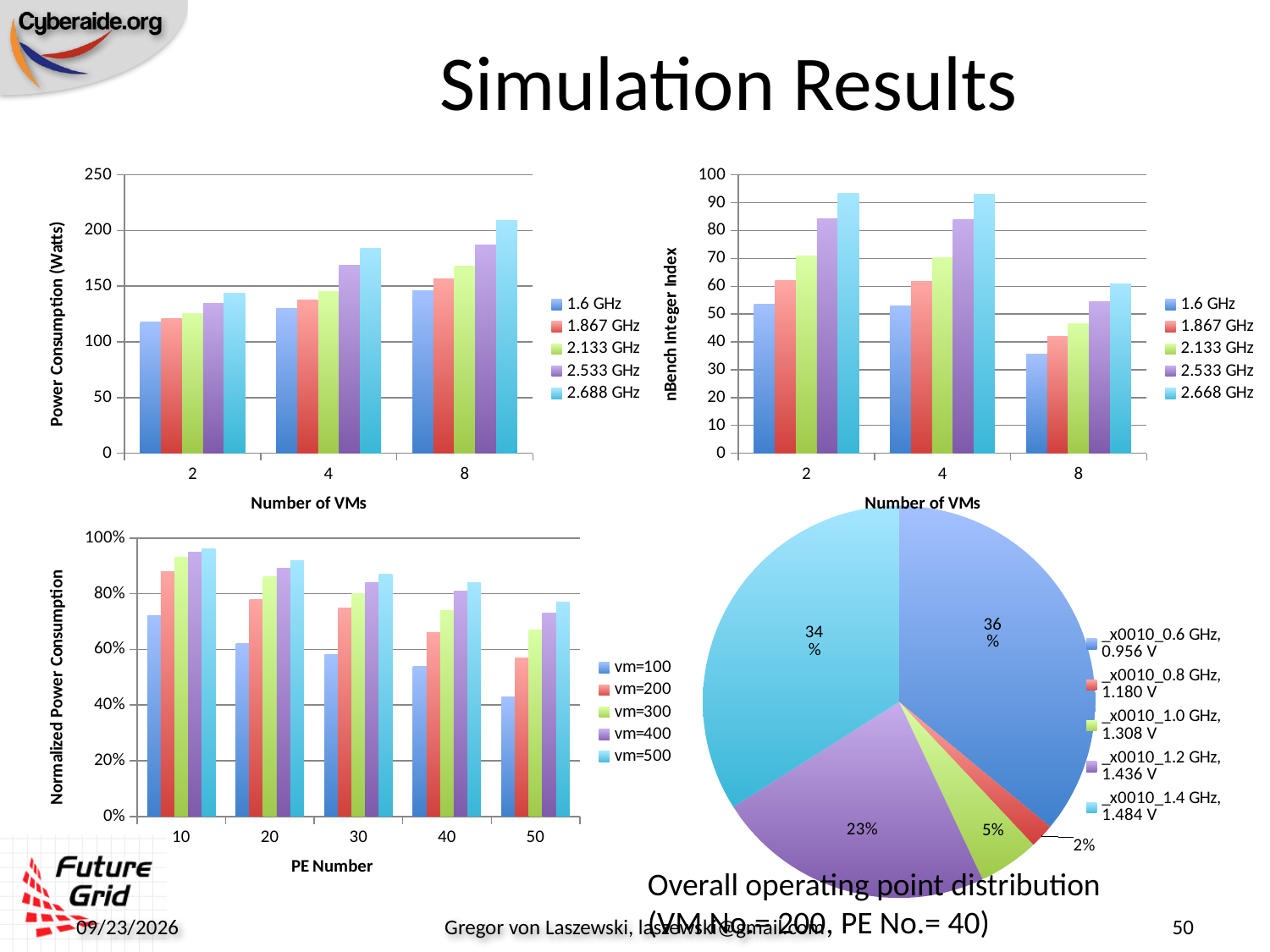
In the bottom-left Normalized Power Consumption chart, how many PE Number categories are on the x axis? 5 In the top-left Power Consumption chart, how many Number of VMs categories are shown on the x axis? 3 In the top-left Power Consumption chart, does the 2.688 GHz series rise or fall as the Number of VMs increases? rises In the top-right nBench Integer Index chart, which Number of VMs has the lowest value for 1.6 GHz? 8 In the pie chart 'Overall operating point distribution', which operating point has the smallest slice? 0.8 GHz, 1.180 V In the top-right nBench Integer Index chart, is the value for 2.668 GHz at 8 VMs greater or less than 50? greater In the bottom-left Normalized Power Consumption chart, does the vm=100 series rise or fall as PE Number increases? falls In the pie chart 'Overall operating point distribution', what share does the 1.2 GHz, 1.436 V slice have? 23% In the top-left Power Consumption chart, how many series does the legend list? 5 In the top-left Power Consumption chart, is the value for 2.688 GHz at 8 VMs greater or less than 200? greater In the pie chart 'Overall operating point distribution', what is the difference between the 36% slice and the 34% slice? 2% What kind of chart is the top-left chart titled 'Power Consumption (Watts)' vs 'Number of VMs'? bar chart